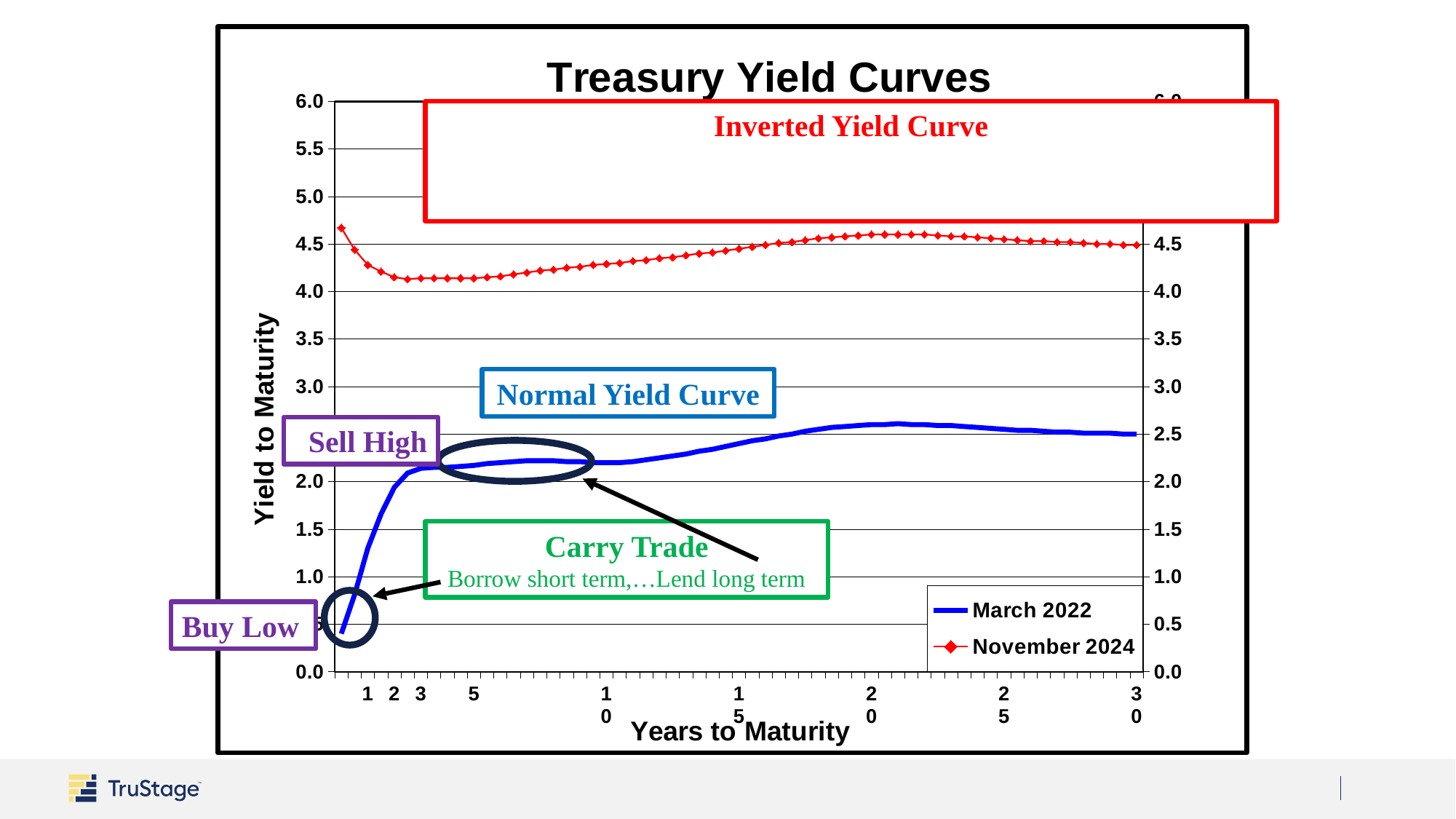
Is the March 2022 yield at 5 years to maturity greater or less than 2.5? less Which two series are listed in the legend? March 2022 and November 2024 How many series does the legend list? 2 Does the March 2022 yield curve rise or fall between 1 and 10 years to maturity? rise Is the November 2024 yield at 20 years to maturity greater or less than 4.5? greater What kind of chart is shown on the slide? line chart Which series has the higher yield at 10 years to maturity, March 2022 or November 2024? November 2024 Which series lies above the other across the whole range of maturities? November 2024 Is the March 2022 yield at 5 years to maturity greater or less than 2.0? greater What is the title of the chart? Treasury Yield Curves